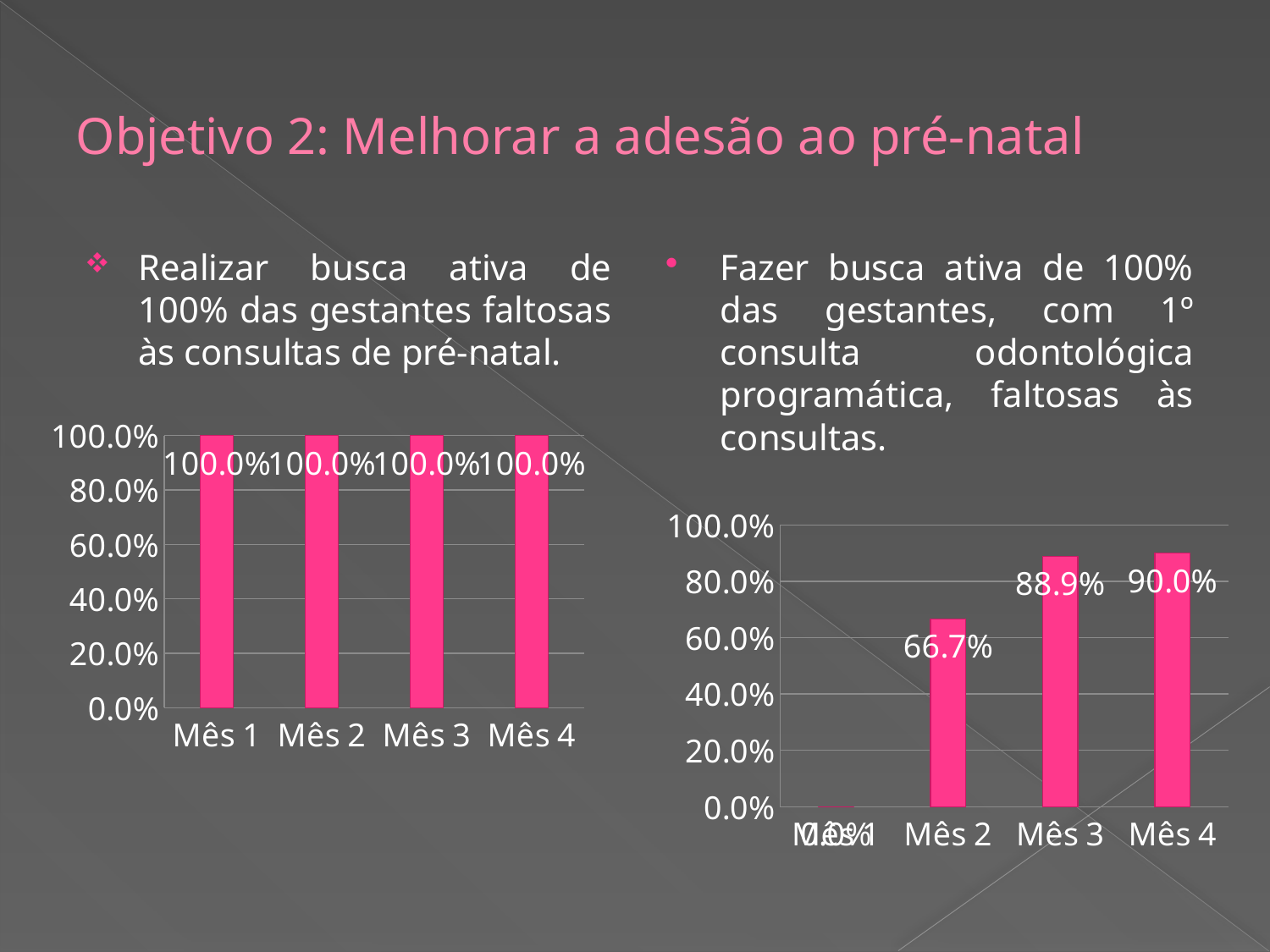
On the right chart, which is larger, the value for Mês 2 or the value for Mês 3? Mês 3 On the right chart, is the value for Mês 2 greater or less than 60.0%? greater What kind of chart is the right chart? bar chart On the left chart, what is the value for Mês 3? 100.0% On the right chart, what is the value for Mês 4? 90.0% On the right chart, do the values rise or fall from Mês 1 to Mês 4? rise How many categories are shown on the left chart? 4 On the right chart, which month has the lowest value? Mês 1 On the right chart, what is the value for Mês 2? 66.7% On the right chart, what is the value for Mês 3? 88.9% On the right chart, what is the difference between the values for Mês 4 and Mês 2? 23.3% On the right chart, which month has the highest value? Mês 4